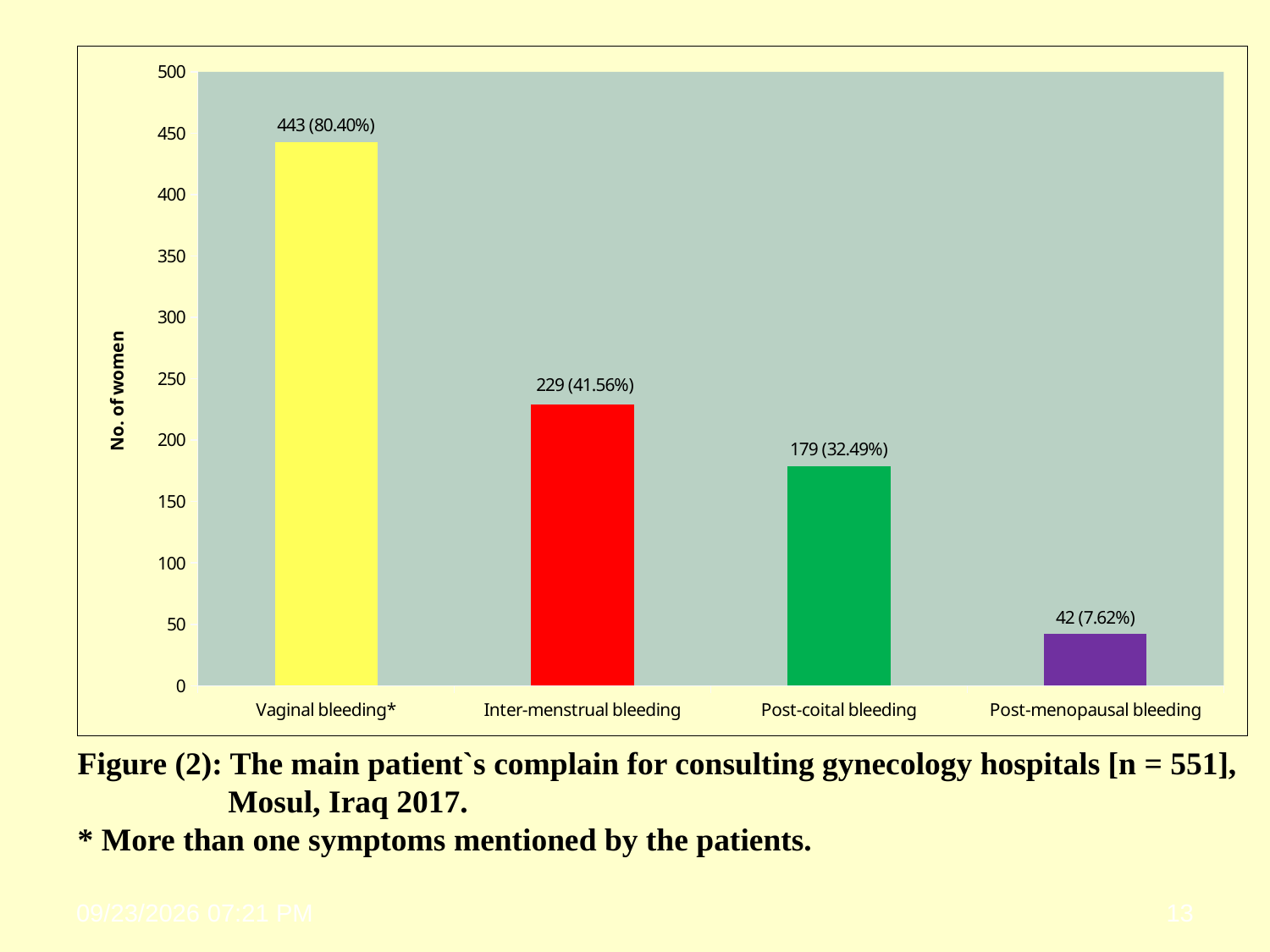
What kind of chart is shown on the slide? Bar chart What percentage is shown for inter-menstrual bleeding? 41.56% What is the difference in the number of women between post-coital bleeding and post-menopausal bleeding? 137 What is the data label shown for post-menopausal bleeding? 42 (7.62%) What is the number of women reporting vaginal bleeding? 443 Which complaint has the lowest number of women? Post-menopausal bleeding What is the difference in the number of women between vaginal bleeding and inter-menstrual bleeding? 214 Which has more women: inter-menstrual bleeding or post-coital bleeding? Inter-menstrual bleeding How many complaint categories are shown on the chart? 4 Which complaint has the highest number of women? Vaginal bleeding* What is the label of the y axis? No. of women What is the number of women reporting post-coital bleeding? 179